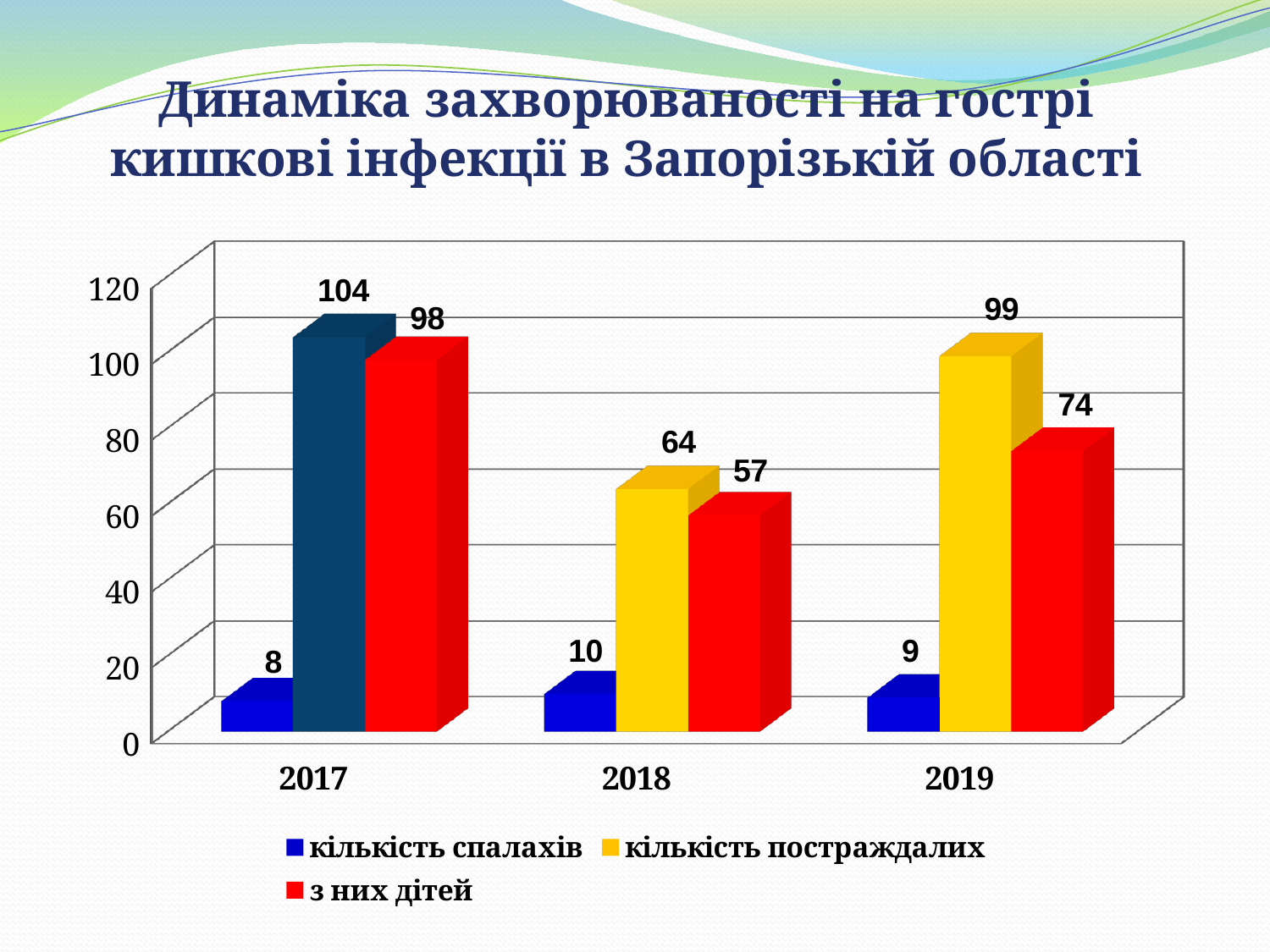
In which year is 'з них дітей' the highest? 2017 What is the value of 'кількість спалахів' for 2018? 10 What is the value of the middle bar for 2017? 104 How many series does the legend list? 3 What is the value of 'кількість постраждалих' for 2019? 99 What type of chart is shown on the slide? bar chart What is the difference between 'кількість постраждалих' and 'з них дітей' in 2019? 25 Which is larger: 'з них дітей' in 2018 or 'з них дітей' in 2019? 2019 In which year is 'кількість спалахів' the lowest? 2017 What is the value of 'з них дітей' for 2019? 74 How many years are shown on the x axis? 3 What is the title of the chart? Динаміка захворюваності на гострі кишкові інфекції в Запорізькій області